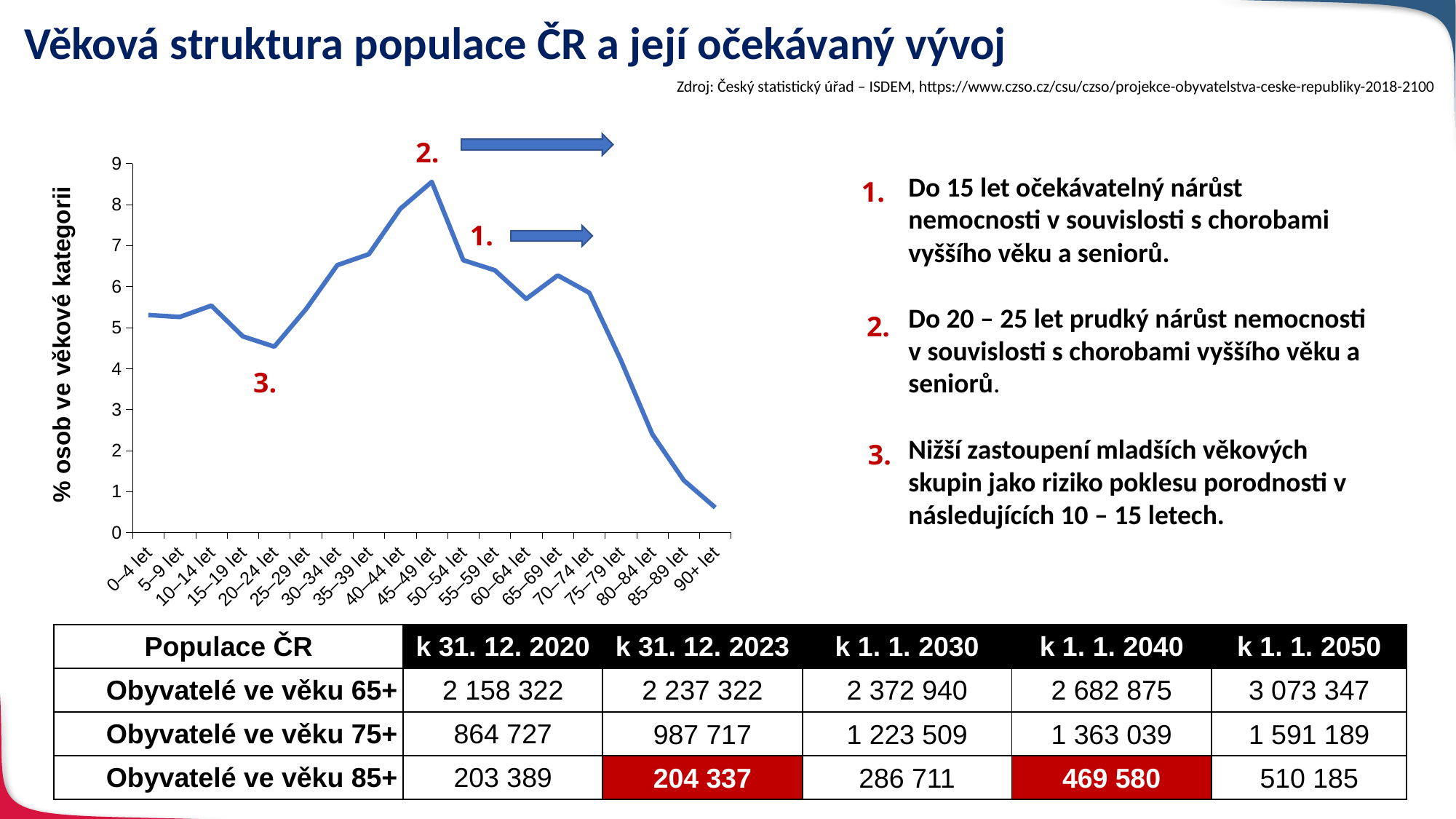
Is the value for 80–84 let greater or less than 3? less Which has the larger value, 0–4 let or 20–24 let? 0–4 let What kind of chart is shown on the slide? line chart Which age category has the lowest value in the chart? 90+ let Is the value for 45–49 let greater or less than 8? greater Is the value for 70–74 let greater or less than 5? greater What is the title of the vertical axis of the chart? % osob ve věkové kategorii How many age categories are plotted along the x axis of the chart? 19 Do the values rise or fall along the x axis from 45–49 let to 90+ let? fall Which age category has the highest value in the chart? 45–49 let